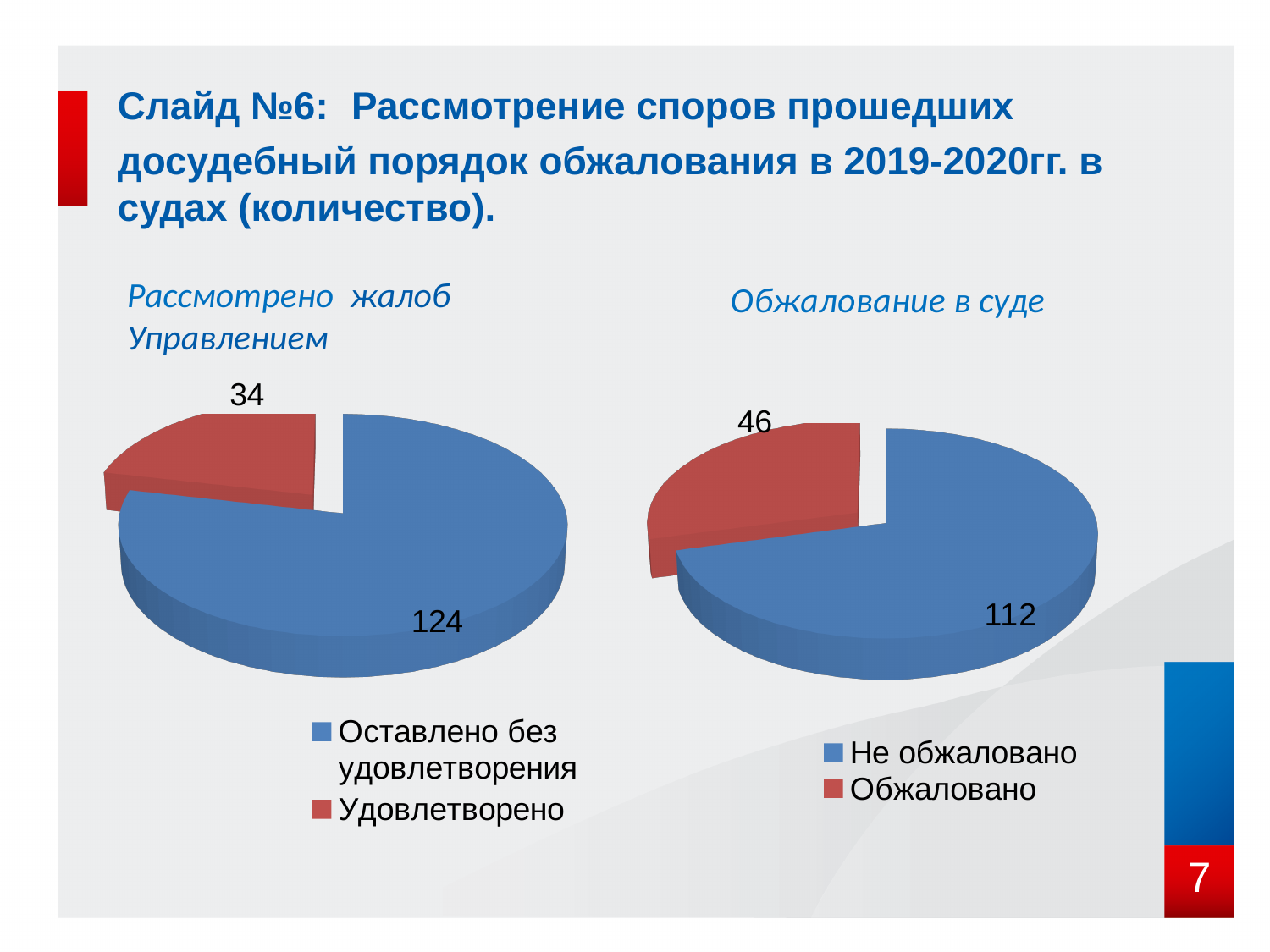
In the left pie chart "Рассмотрено жалоб Управлением", which category has the largest slice? Оставлено без удовлетворения In the right pie chart "Обжалование в суде", which category has the smallest slice? Обжаловано In the left pie chart "Рассмотрено жалоб Управлением", what is the difference between "Оставлено без удовлетворения" and "Удовлетворено"? 90 In the right pie chart "Обжалование в суде", what is the difference between "Не обжаловано" and "Обжаловано"? 66 How many categories does the legend of the right pie chart "Обжалование в суде" list? 2 What is the total of the two values in the left pie chart "Рассмотрено жалоб Управлением"? 158 In the left pie chart "Рассмотрено жалоб Управлением", what is the value for "Удовлетворено"? 34 In the left pie chart "Рассмотрено жалоб Управлением", what is the value for "Оставлено без удовлетворения"? 124 In the right pie chart "Обжалование в суде", what is the value for "Не обжаловано"? 112 Which is larger: "Удовлетворено" in the left pie chart or "Обжаловано" in the right pie chart? Обжаловано What type of chart is used on this slide? Pie chart In the right pie chart "Обжалование в суде", what is the value for "Обжаловано"? 46